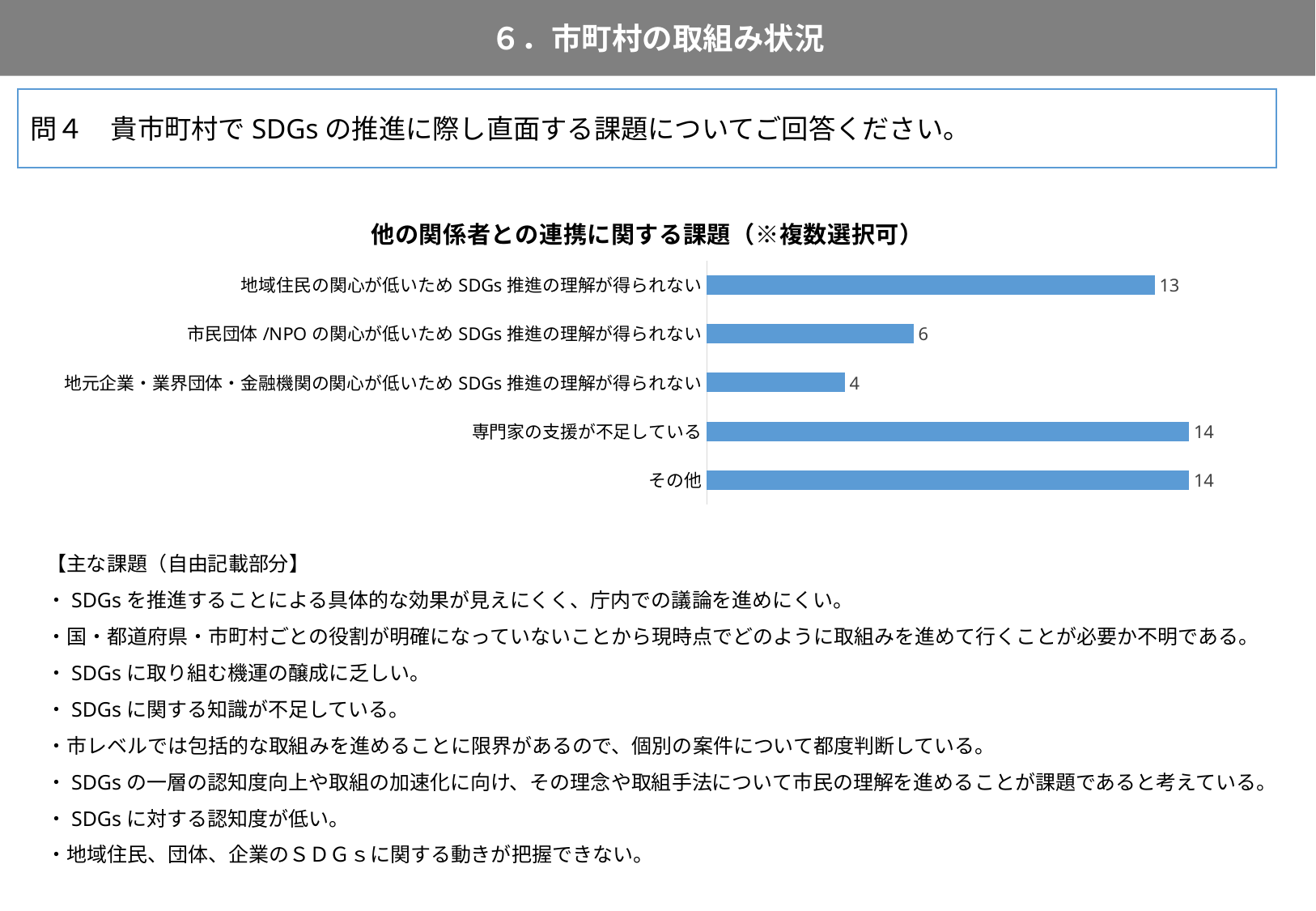
What is the difference between the values for 専門家の支援が不足している and 市民団体 /NPO の関心が低いため SDGs 推進の理解が得られない? 8 What kind of chart is shown on the slide? Bar chart What is the title of the chart? 他の関係者との連携に関する課題（※複数選択可） What is the value for その他? 14 What is the value for 地域住民の関心が低いため SDGs 推進の理解が得られない? 13 What is the difference between the values for 地域住民の関心が低いため SDGs 推進の理解が得られない and 地元企業・業界団体・金融機関の関心が低いため SDGs 推進の理解が得られない? 9 Which is larger, the value for 地域住民の関心が低いため SDGs 推進の理解が得られない or the value for 市民団体 /NPO の関心が低いため SDGs 推進の理解が得られない? 地域住民の関心が低いため SDGs 推進の理解が得られない Which category has the lowest value? 地元企業・業界団体・金融機関の関心が低いため SDGs 推進の理解が得られない How many categories are shown in the chart? 5 What is the value for 地元企業・業界団体・金融機関の関心が低いため SDGs 推進の理解が得られない? 4 What is the value for 市民団体 /NPO の関心が低いため SDGs 推進の理解が得られない? 6 What is the value for 専門家の支援が不足している? 14